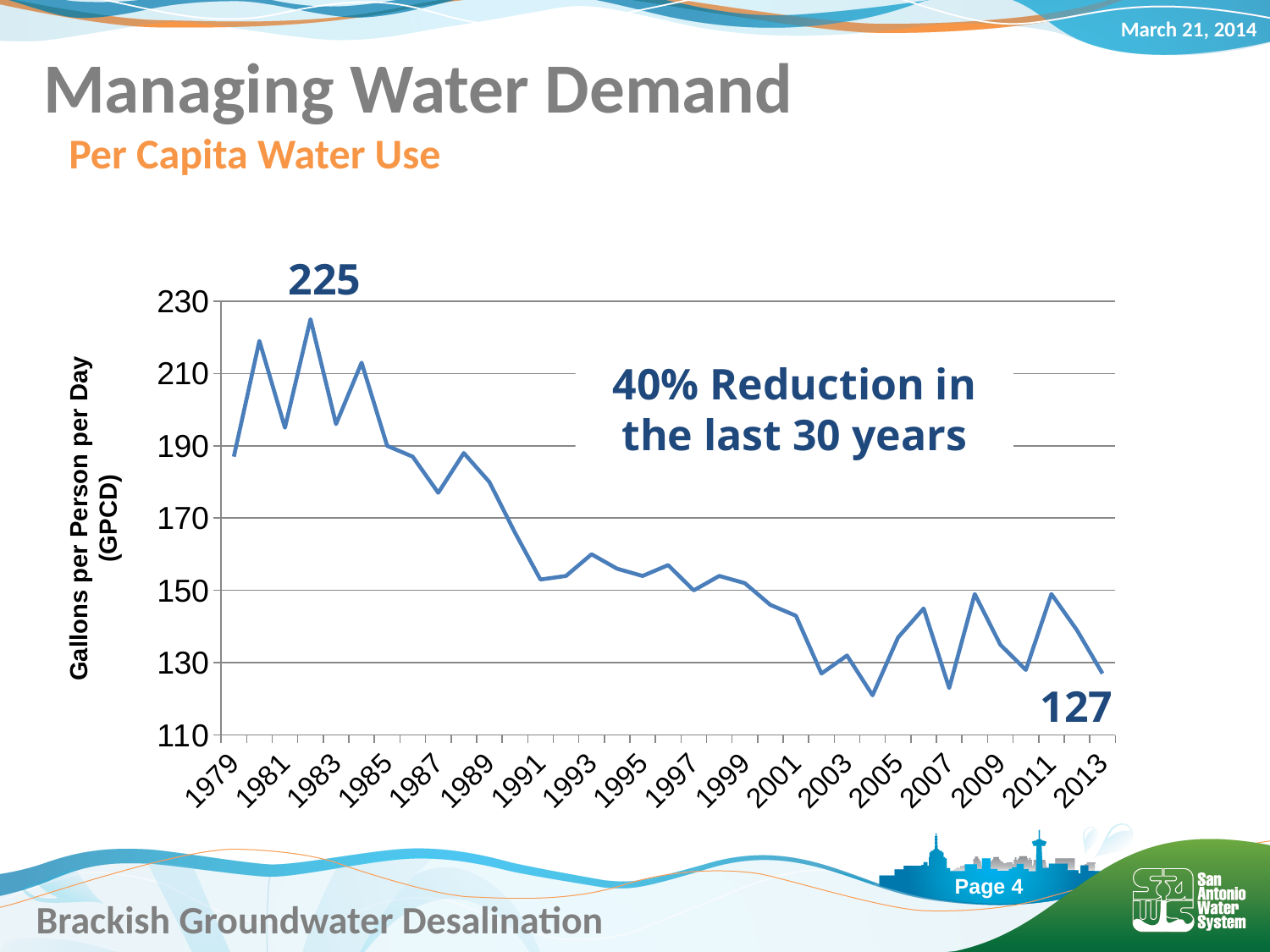
Overall, do the values rise or fall from 1979 to 2013? fall Is the value for 2001 greater or less than 150? less Which is larger, the value for 1982 or the value for 2013? 1982 Is the value for 1987 greater or less than 170? greater What is the difference between the labelled peak value of 225 and the 2013 value of 127? 98 Is the value for 2004 greater or less than 130? less What is the highest value labelled on the per capita water use chart? 225 What is the per capita water use value labelled for 2013? 127 What kind of chart is shown on the slide? line chart What reduction does the annotation on the chart state occurred in the last 30 years? 40% Reduction What is the label on the vertical axis of the chart? Gallons per Person per Day (GPCD)